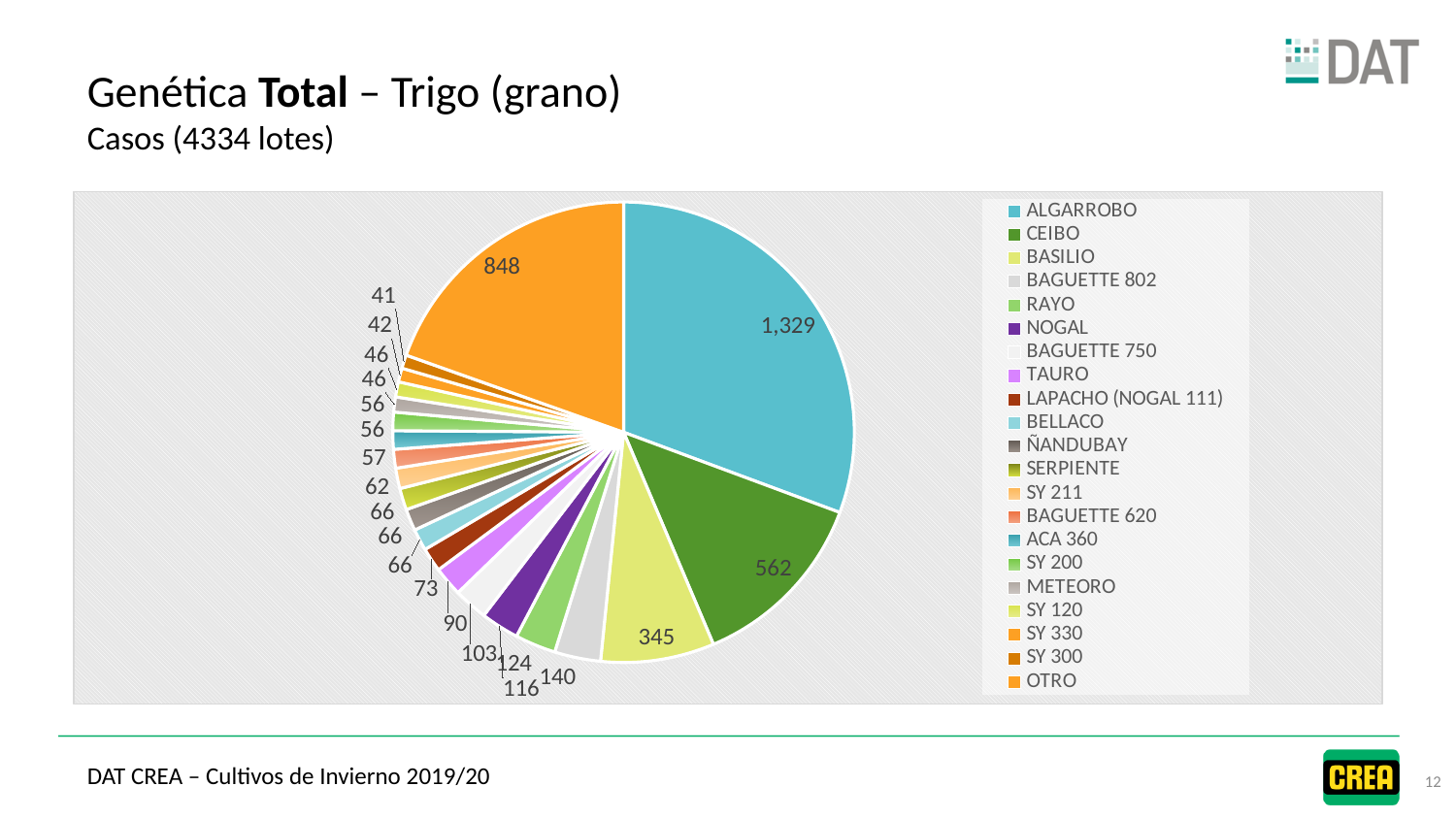
Which is larger, the OTRO slice or the CEIBO slice? OTRO How many categories does the legend list? 21 How many cases (lotes) does the ALGARROBO slice show? 1,329 What is the value shown for BASILIO? 345 What is the value shown for the OTRO slice? 848 Which category has the largest slice of the pie? ALGARROBO What is the difference between the values for ALGARROBO and CEIBO? 767 What is the value shown for CEIBO? 562 What is the difference between the values for CEIBO and BASILIO? 217 Which category has the smallest slice of the pie? SY 300 What is the title of the slide above the chart? Genética Total – Trigo (grano) What kind of chart is shown on the slide? pie chart